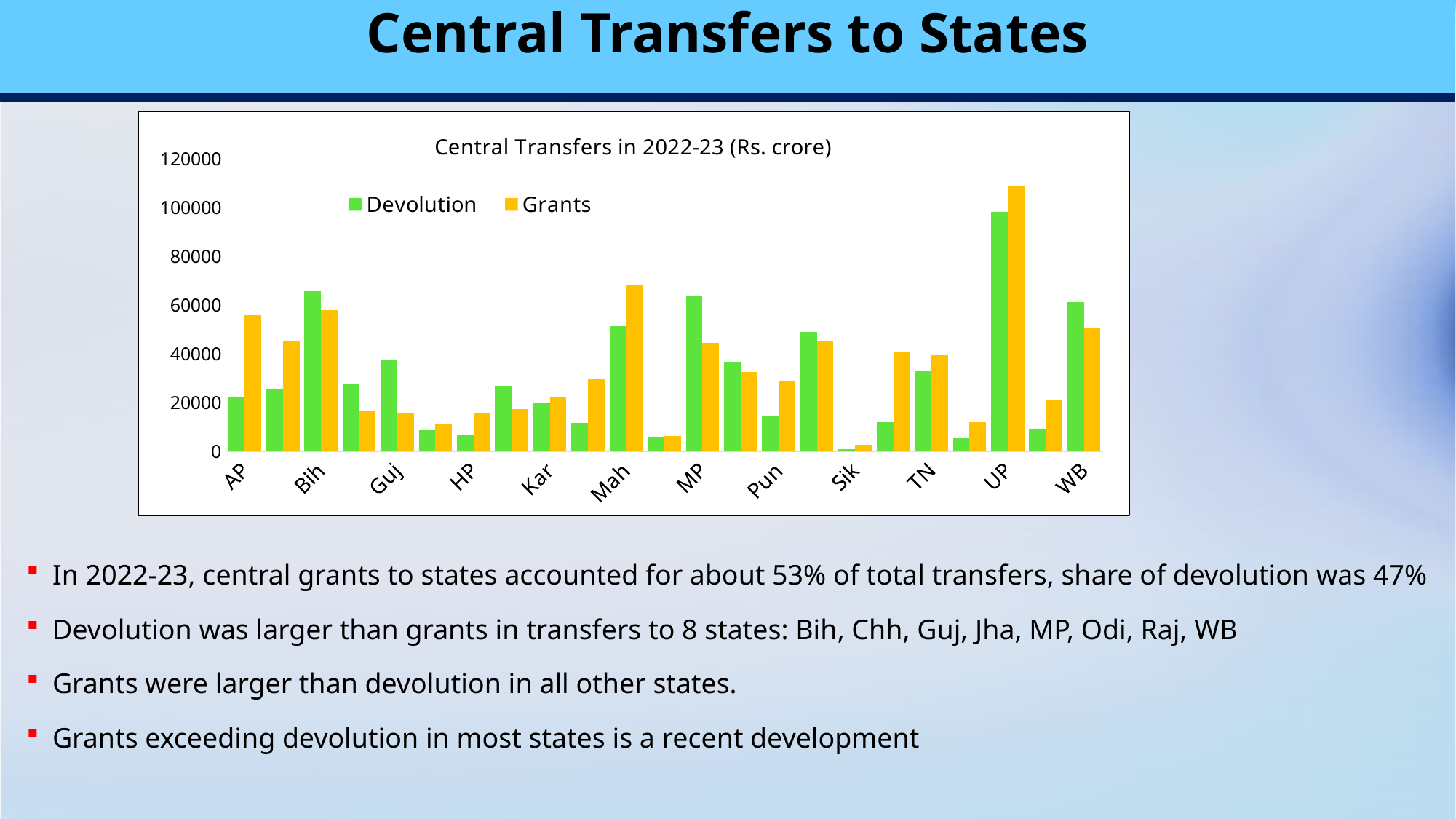
What are the two series named in the chart legend? Devolution and Grants For Bih, which is larger: Devolution or Grants? Devolution Is the Grants value for UP greater or less than 100000? greater Which state has the highest Devolution value in the chart? UP How many series does the chart legend list? 2 Is the Grants value for AP greater or less than 40000? greater What is the title of the chart? Central Transfers in 2022-23 (Rs. crore) Is the Devolution value for Sik greater or less than 20000? less What kind of chart is shown on the slide? bar chart Which state has the highest Grants value in the chart? UP Which labelled state has the lowest Devolution value in the chart? Sik For Mah, which is larger: Devolution or Grants? Grants